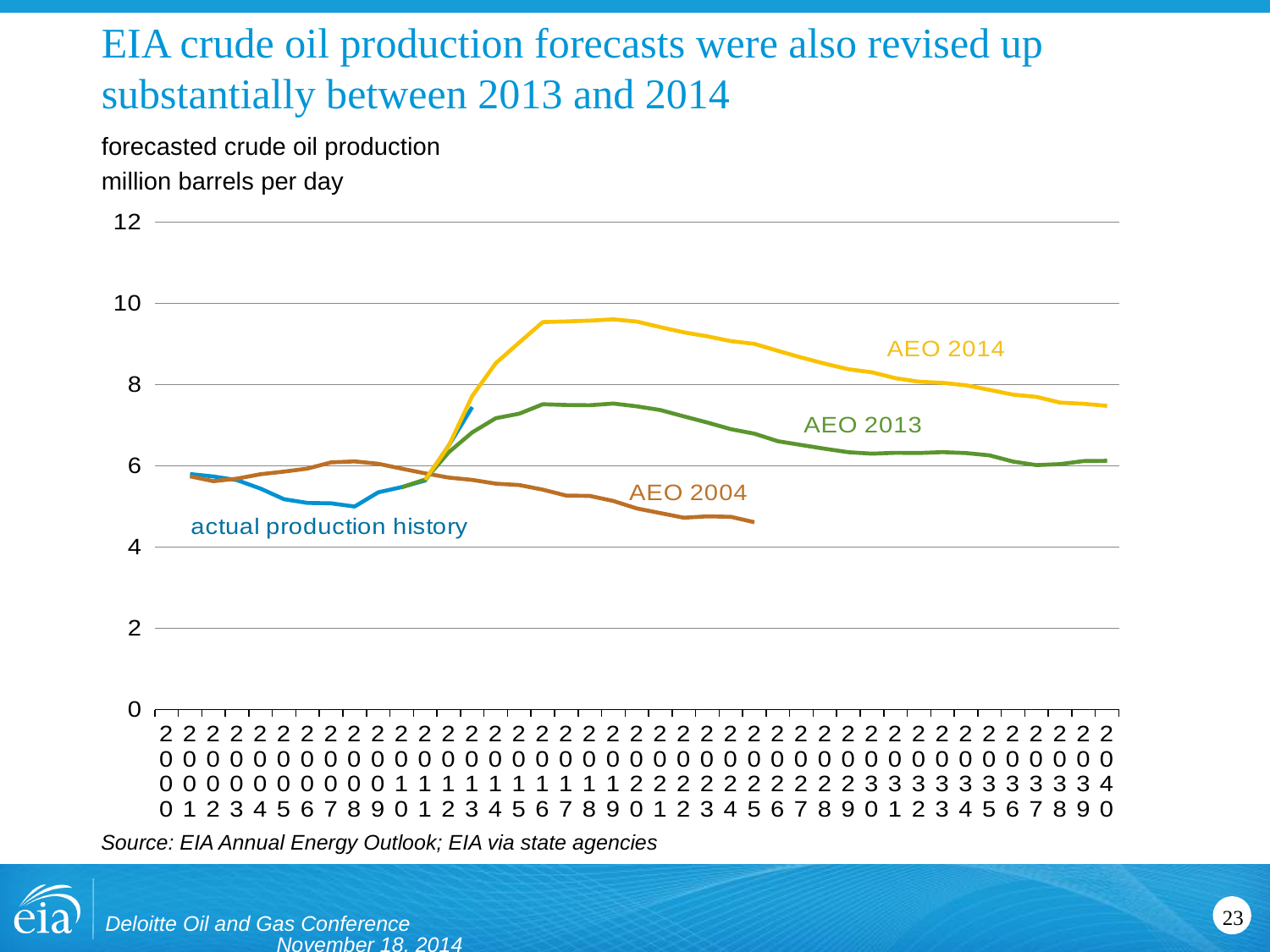
How many labeled series (lines) are plotted on the chart? 4 What colour is the AEO 2014 line? yellow Does the AEO 2004 line rise or fall between 2010 and 2025? fall Is the peak value of the AEO 2014 line greater or less than 8? greater In 2040, which is higher: the AEO 2014 line or the AEO 2013 line? AEO 2014 What unit is the y axis measured in, according to the subtitle? million barrels per day Is the peak value of the AEO 2014 line greater or less than 10? less Which forecast series ends at the lowest value? AEO 2004 What kind of chart is shown on the slide? line chart Is the AEO 2004 value in 2025 greater or less than 6? less Which series reaches the highest value on the chart? AEO 2014